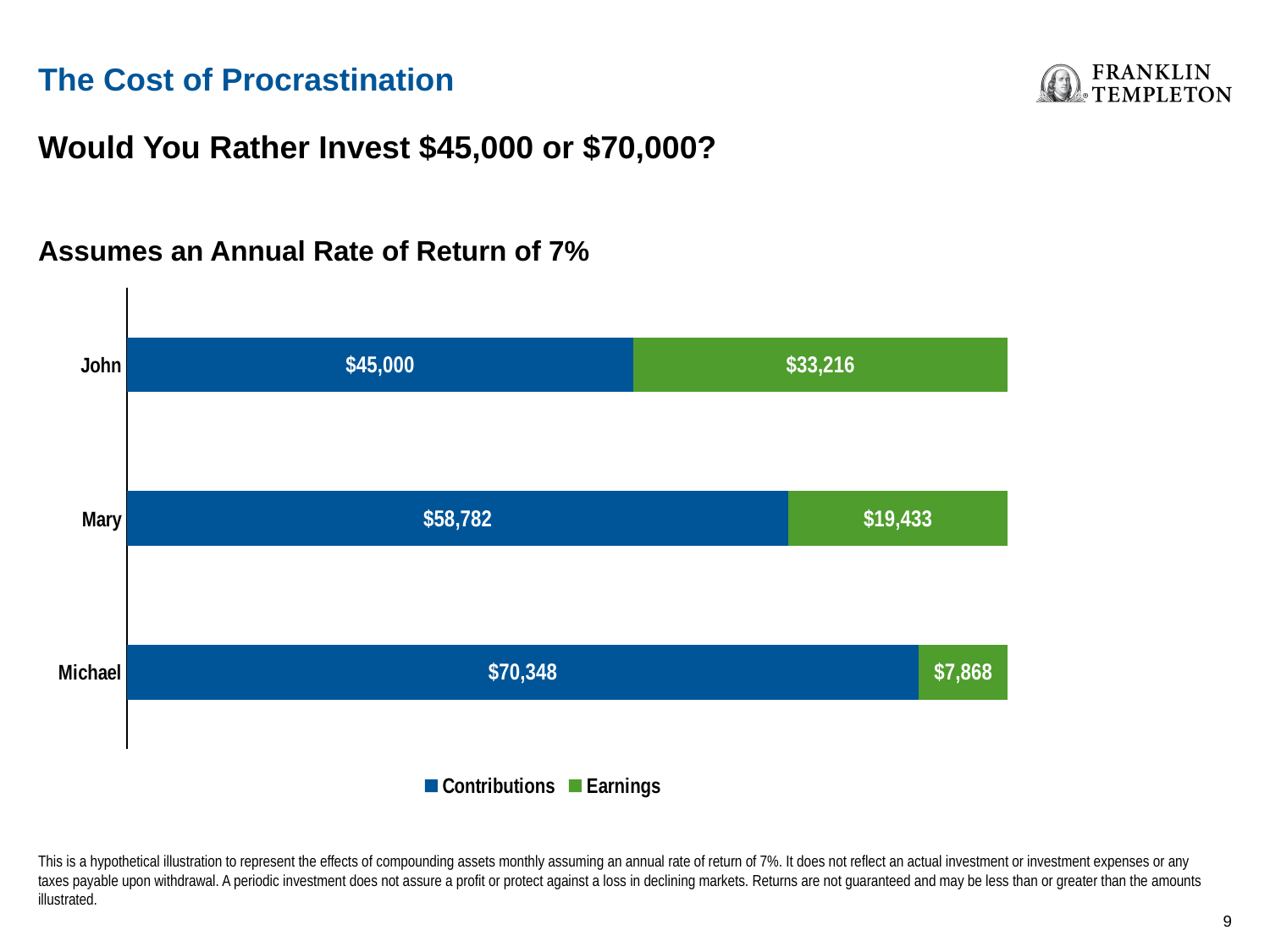
What is the Contributions value for John? $45,000 What is the difference between Michael's Contributions and John's Contributions? $25,348 What is the total of John's bar (Contributions plus Earnings)? $78,216 Which person has the lowest Earnings value? Michael Which person has the highest Earnings value? John Which is larger: Mary's Contributions or Michael's Contributions? Michael's Contributions What is the Earnings value for Mary? $19,433 What kind of chart is shown on the slide? Stacked bar chart What is the Earnings value for Michael? $7,868 How many people are shown on the chart? 3 Which person has the highest Contributions value? Michael How many series does the legend list? 2